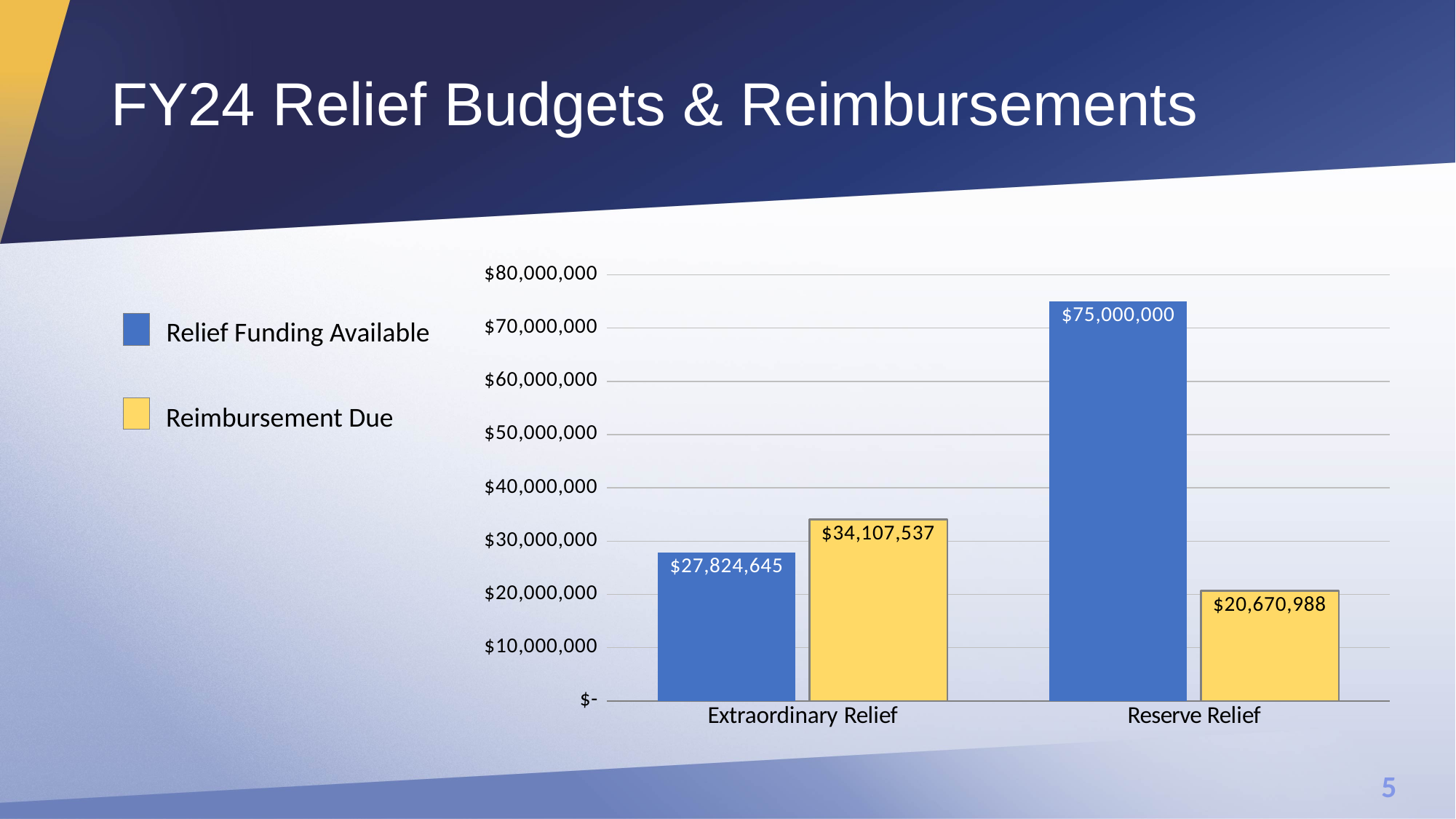
For Extraordinary Relief, which is larger: Relief Funding Available or Reimbursement Due? Reimbursement Due What is the Relief Funding Available for Extraordinary Relief? $27,824,645 How many series does the legend list? 2 How many categories are shown on the x axis of the chart? 2 What is the Reimbursement Due for Extraordinary Relief? $34,107,537 Which category has the highest Relief Funding Available? Reserve Relief What is the difference between Relief Funding Available and Reimbursement Due for Reserve Relief? $54,329,012 What is the Reimbursement Due for Reserve Relief? $20,670,988 What is the Relief Funding Available for Reserve Relief? $75,000,000 What is the difference between Reimbursement Due and Relief Funding Available for Extraordinary Relief? $6,282,892 Which category has the lowest Reimbursement Due? Reserve Relief What kind of chart is shown on the slide? Bar chart